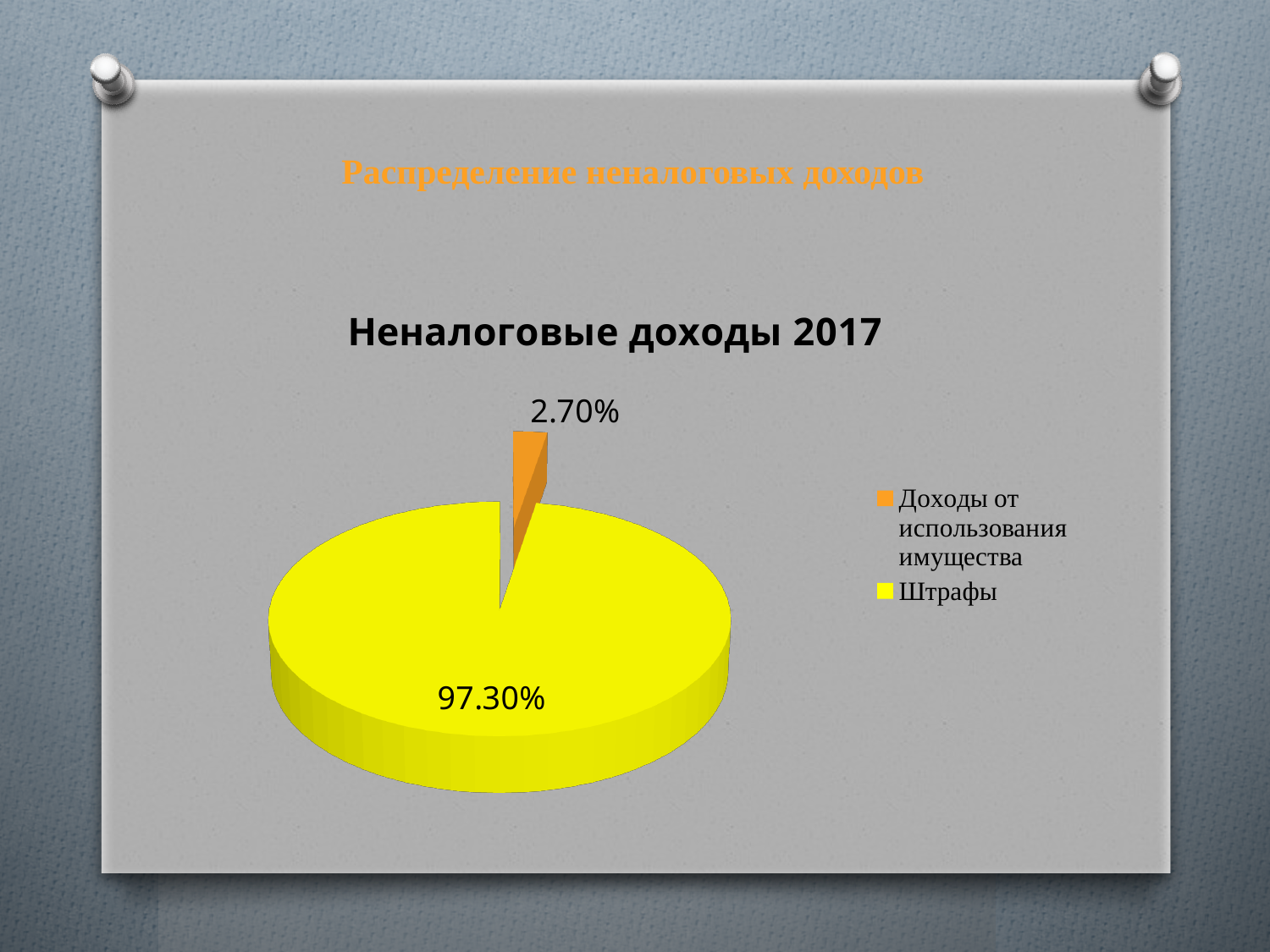
What is the difference in percentage points between the Штрафы slice and the Доходы от использования имущества slice? 94.60% What share of the pie does Доходы от использования имущества represent? 2.70% What kind of chart is shown on the slide? Pie chart How many categories are shown in the pie chart? 2 What is the title of the chart? Неналоговые доходы 2017 Which category has the largest slice of the pie? Штрафы What colour is the slice for Штрафы? Yellow Which category has the smallest slice of the pie? Доходы от использования имущества What share of the pie does Штрафы represent? 97.30% Which is larger: the slice for Штрафы or the slice for Доходы от использования имущества? Штрафы